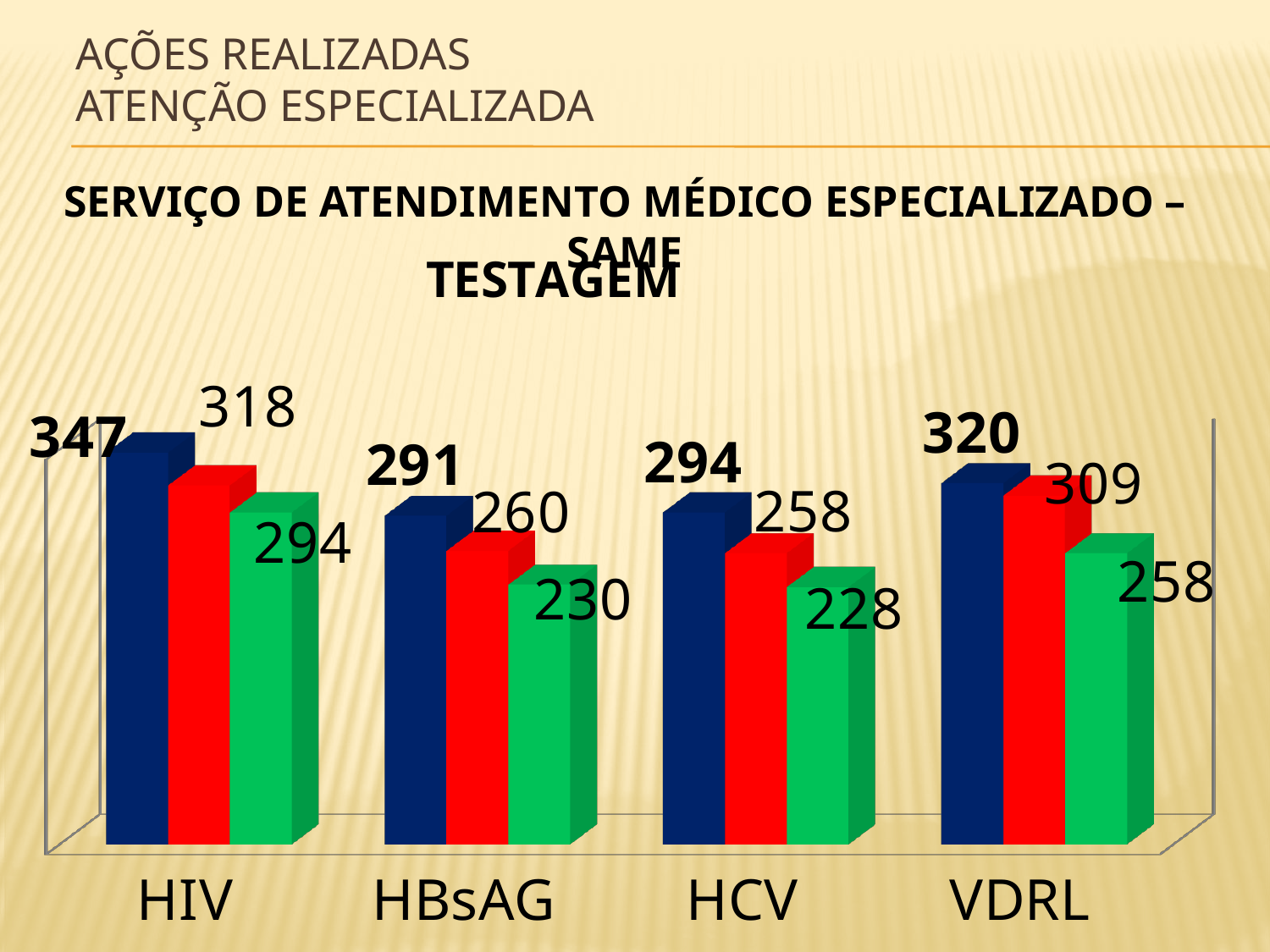
What is the value of the red bar for HCV? 258 Which category has the lowest green bar? HCV What is the value of the blue bar for HIV? 347 What is the difference between the blue bar and the green bar for HIV? 53 What type of chart is shown on the slide? bar chart How many categories are shown on the x axis of the chart? 4 What is the value of the red bar for VDRL? 309 How many bars are plotted for each category in the chart? 3 What is the title of the chart? TESTAGEM Which category has the highest blue bar? HIV Which is larger, the blue bar for VDRL or the blue bar for HCV? VDRL What is the value of the green bar for HBsAG? 230